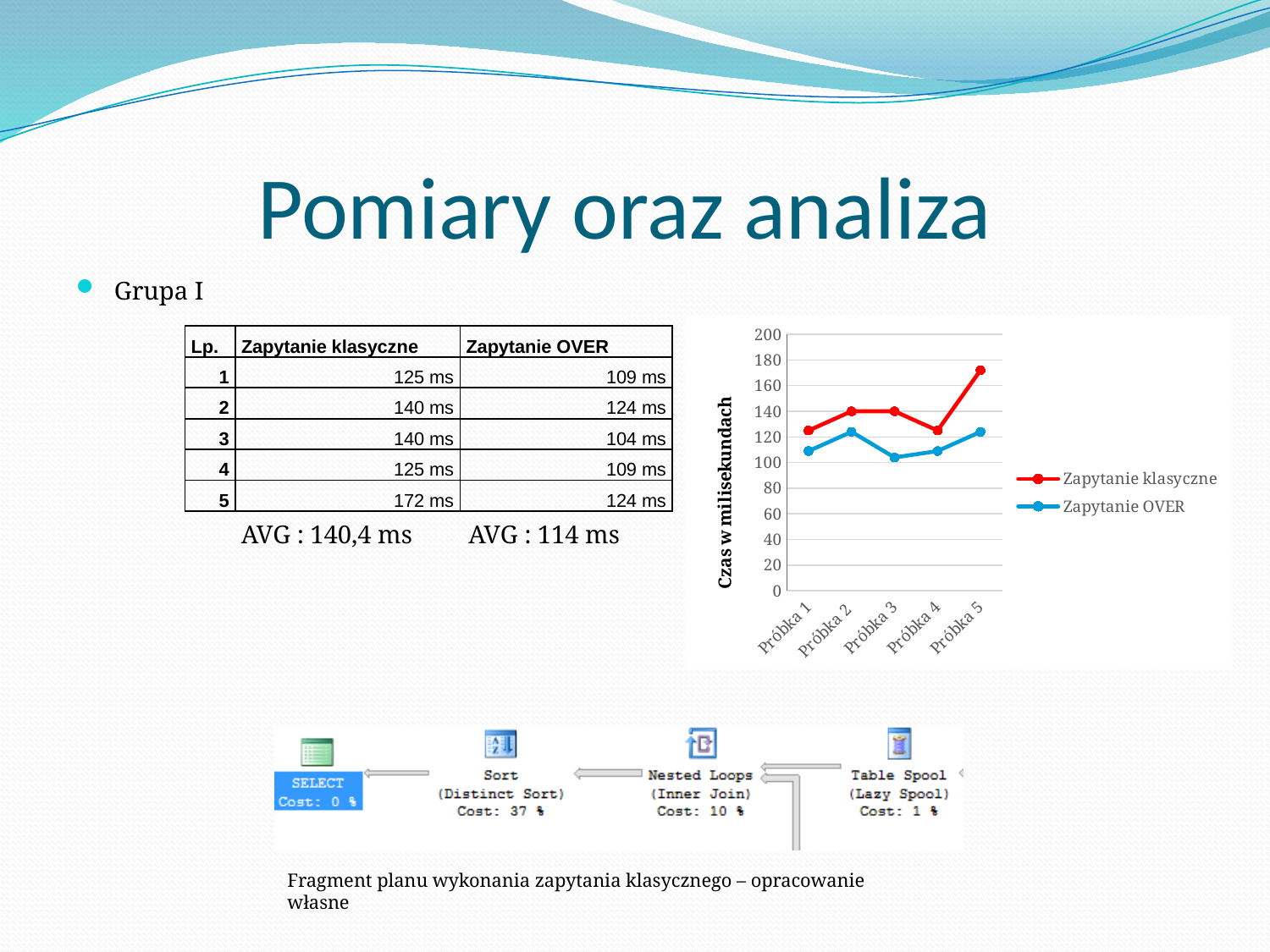
Does the Zapytanie klasyczne series rise or fall from Próbka 4 to Próbka 5? rise What is the title of the chart's vertical axis? Czas w milisekundach For which sample does the Zapytanie klasyczne series reach its highest value? Próbka 5 What is the difference between Zapytanie klasyczne and Zapytanie OVER at Próbka 5? 48 ms What is the value of Zapytanie klasyczne at Próbka 2? 140 ms What kind of chart is shown on the right of the slide? line chart How many series does the chart's legend list? 2 How many samples (Próbka) are plotted along the x axis of the chart? 5 For which sample does the Zapytanie OVER series have its lowest value? Próbka 3 Is the value for Zapytanie OVER at Próbka 3 greater or less than 120? less At Próbka 5, which series has the larger value, Zapytanie klasyczne or Zapytanie OVER? Zapytanie klasyczne Is the value for Zapytanie klasyczne at Próbka 5 greater or less than 160? greater